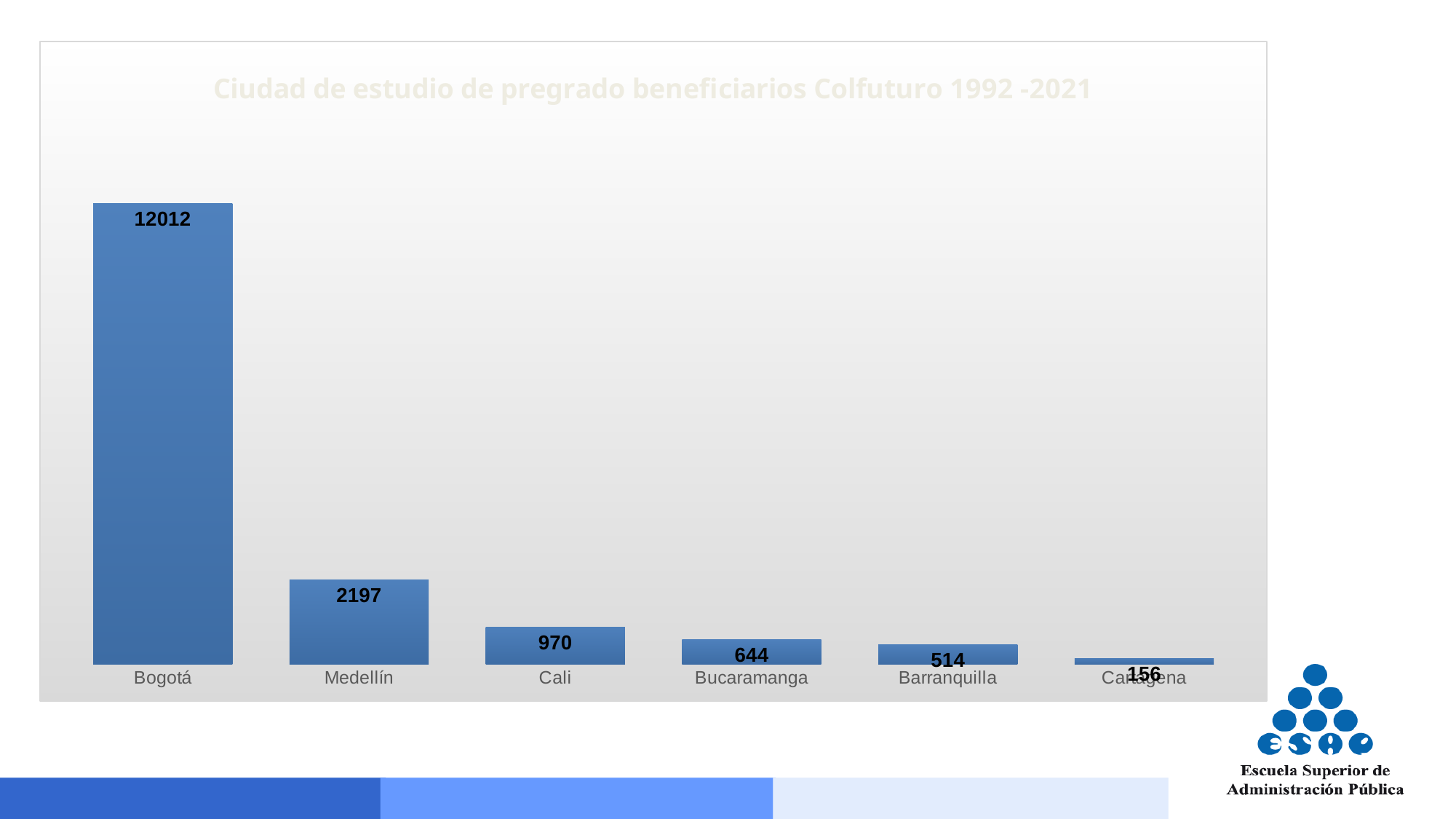
How many cities are shown in the chart? 6 Which city has the highest value? Bogotá What is the value for Bucaramanga? 644 What is the value for Bogotá? 12012 What is the difference between the values for Cali and Bucaramanga? 326 What is the value for Barranquilla? 514 What is the value for Cali? 970 What is the value for Medellín? 2197 Which city has the lowest value? Cartagena What kind of chart is shown on the slide? Bar chart Which is larger, the value for Barranquilla or the value for Cartagena? Barranquilla What is the difference between the values for Bogotá and Medellín? 9815